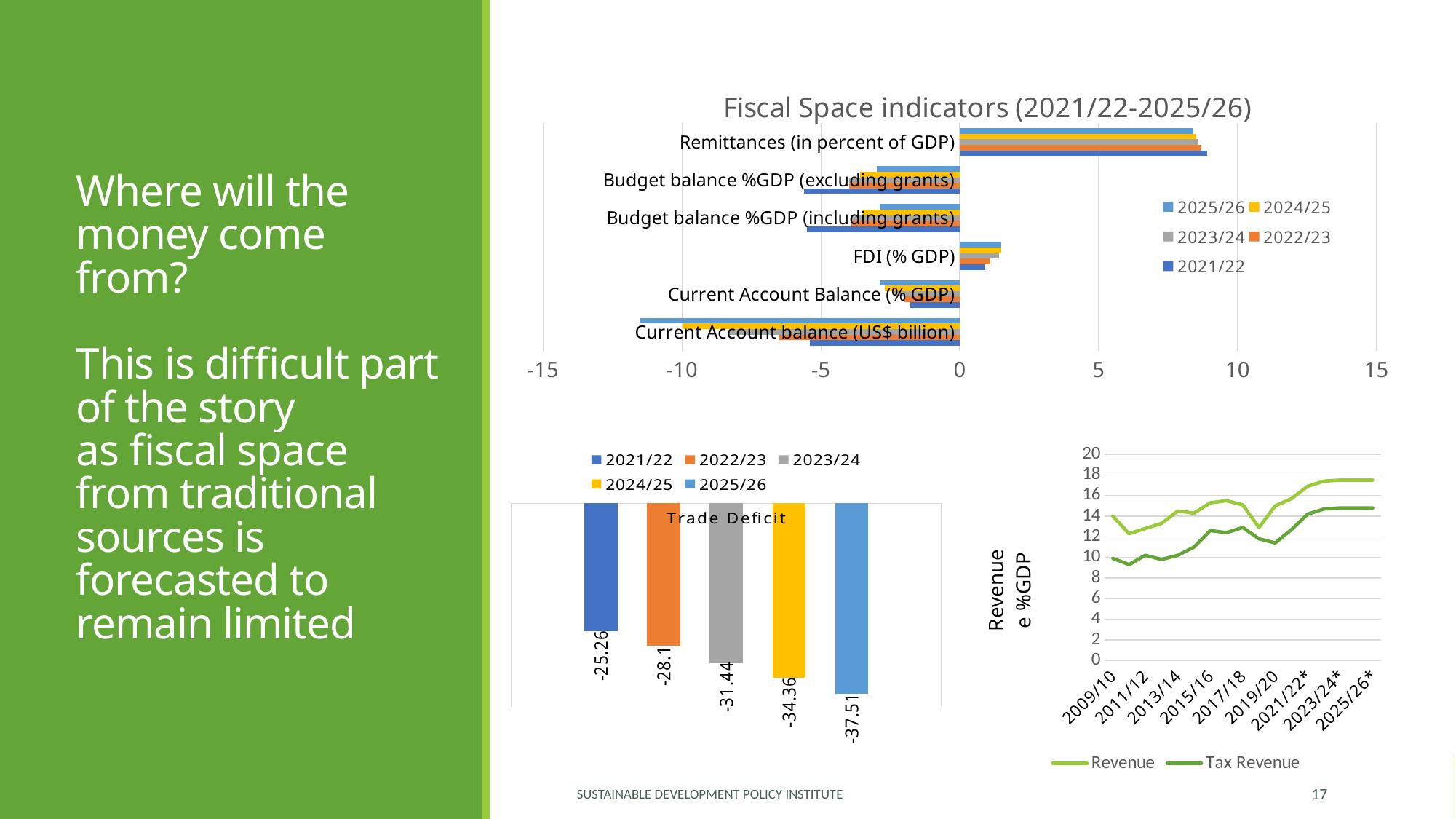
How many series does the legend of the Fiscal Space indicators chart list? 5 In the Trade Deficit chart, what is the value for 2023/24? -31.44 In the Trade Deficit chart, what is the difference between the 2025/26 and 2021/22 values? 12.25 In the Revenue %GDP line chart at the bottom right, which series is higher at 2025/26*, Revenue or Tax Revenue? Revenue In the Trade Deficit chart, what is the value for 2021/22? -25.26 How many categories are shown in the Fiscal Space indicators chart? 6 In the Revenue %GDP line chart at the bottom right, is the Revenue value at 2025/26* greater or less than 16? greater What kind of chart is the Fiscal Space indicators chart? bar chart In the Trade Deficit chart, which year has the lowest (most negative) value? 2025/26 In the Trade Deficit chart, do the values rise or fall from 2021/22 to 2025/26? fall In the Fiscal Space indicators chart, is the 2021/22 value for Remittances (in percent of GDP) greater or less than 5? greater In the Trade Deficit chart, what is the value for 2025/26? -37.51